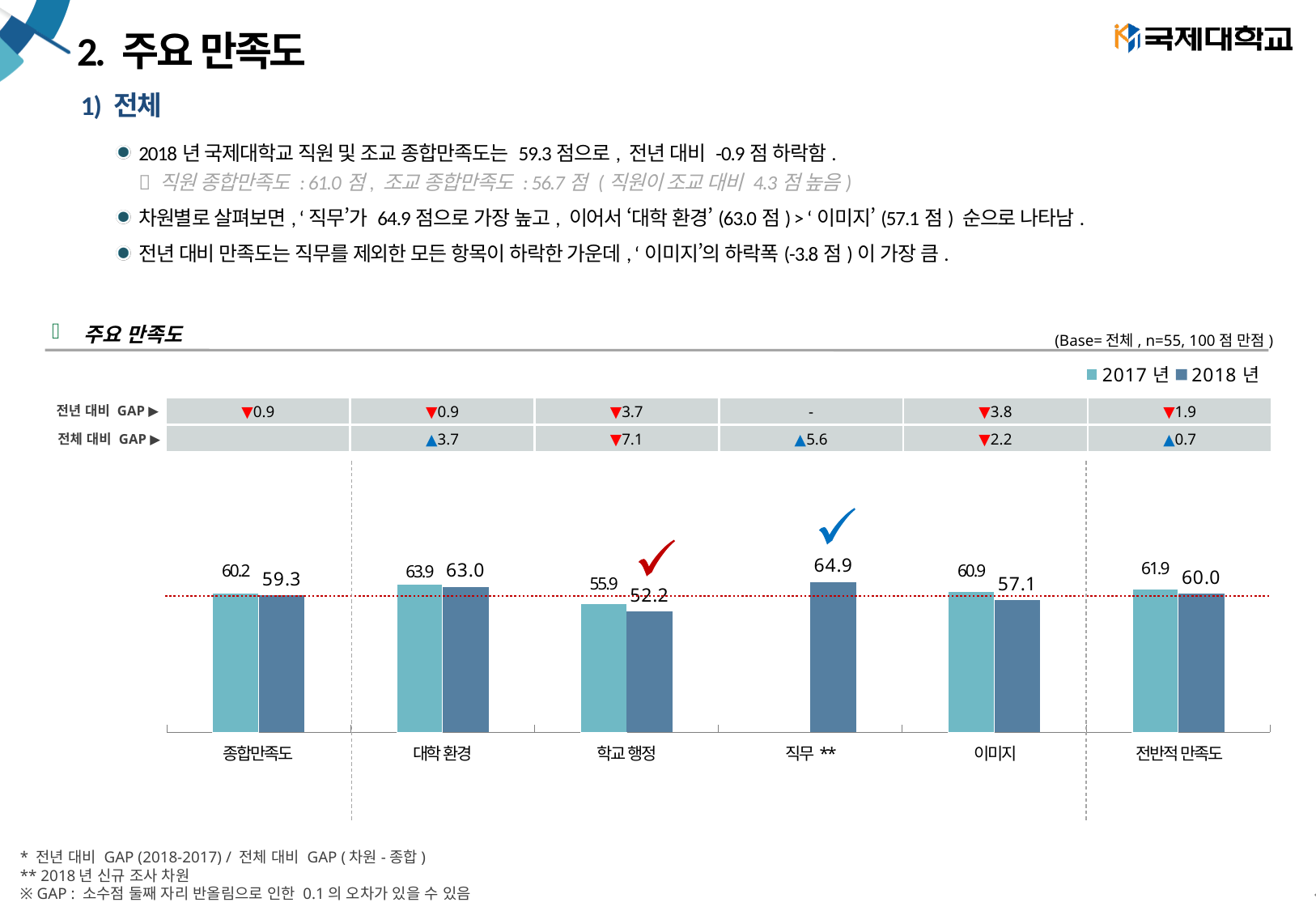
How many series does the legend list? 2 What is the difference between the 2017년 and 2018년 values for 이미지? 3.8 What is the 2018년 value for 직무? 64.9 Which category has the highest 2018년 value? 직무 What is the 2018년 value for 학교 행정? 52.2 How many categories are shown on the x axis of the chart? 6 Which category has no 2017년 bar? 직무 What is the 2018년 value for 종합만족도? 59.3 What is the 2017년 value for 대학 환경? 63.9 Which category has the lowest 2018년 value? 학교 행정 What kind of chart is shown on the slide? Bar chart Which is larger, the 2017년 value for 전반적 만족도 or the 2018년 value for 전반적 만족도? 2017년